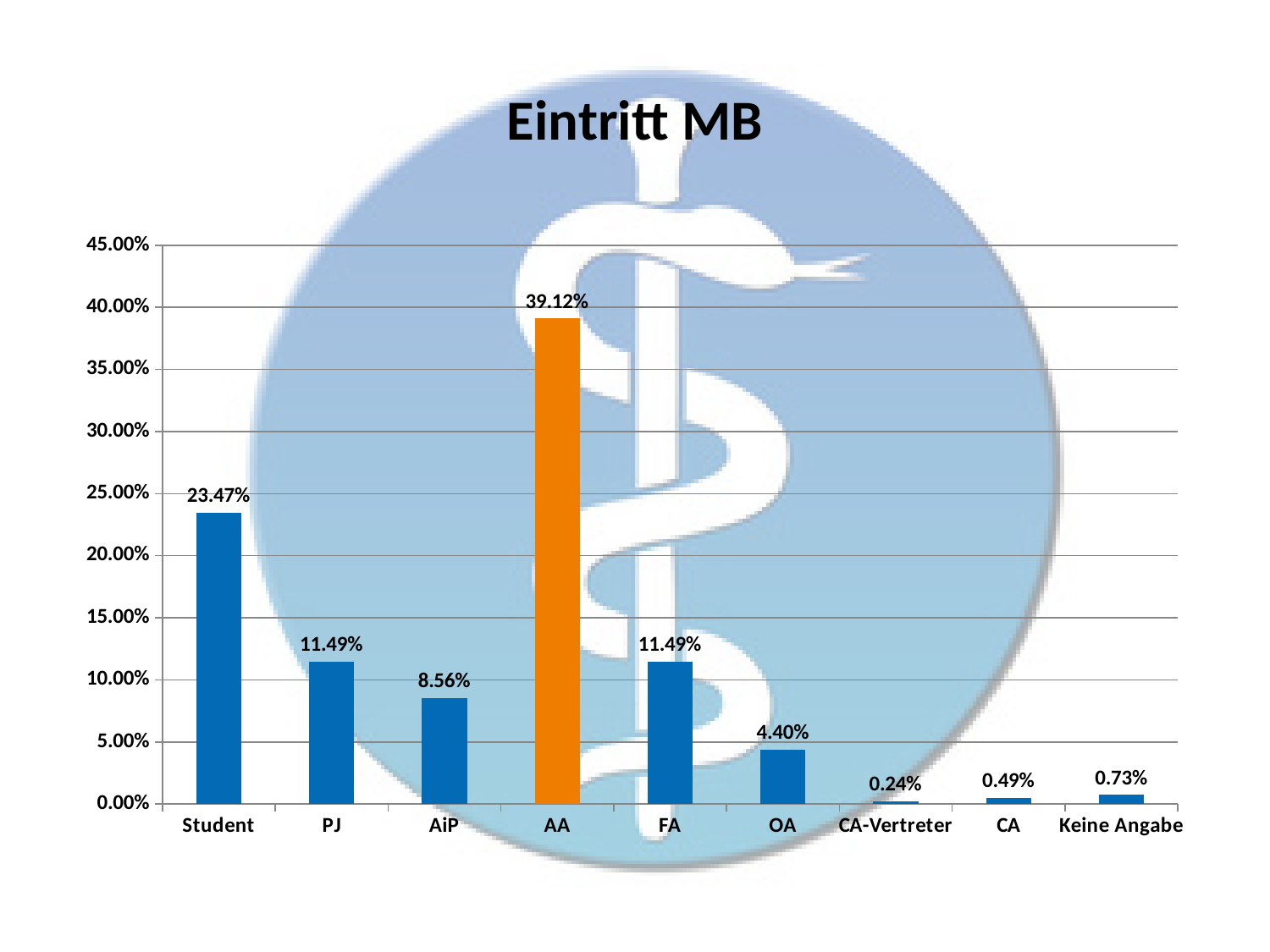
What is the value for AA? 39.12% What is the difference between the values for AiP and OA? 4.16% How many categories are shown on the x axis? 9 What is the value for CA-Vertreter? 0.24% What is the title of the chart? Eintritt MB What is the value for Student? 23.47% What is the difference between the values for AA and Student? 15.65% Which category has the lowest value? CA-Vertreter What kind of chart is this? Bar chart Which is larger, the value for Student or the value for FA? Student What is the value for Keine Angabe? 0.73% Which category has the highest value? AA